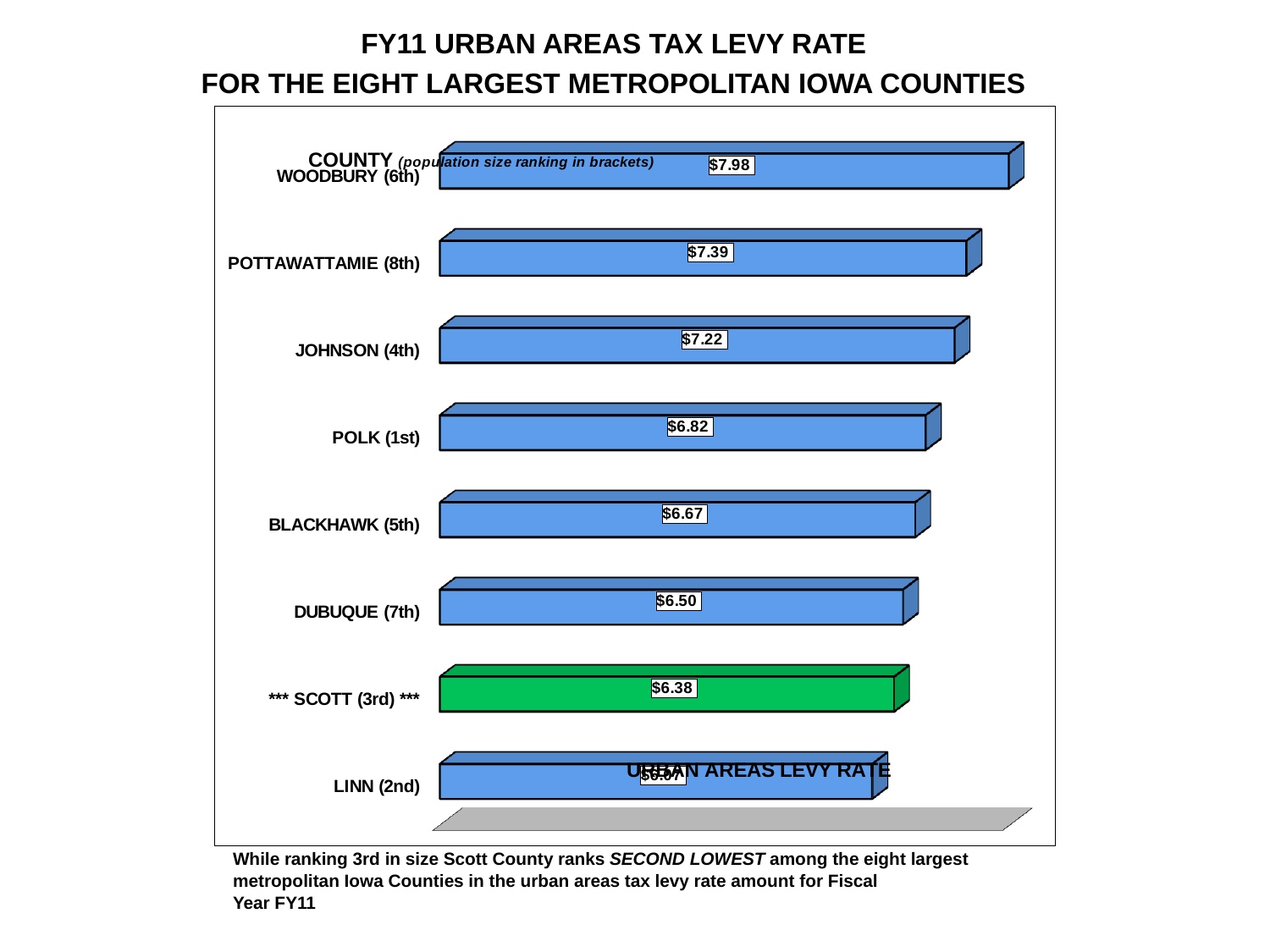
What kind of chart is shown on the slide? Bar chart What is the urban areas tax levy rate for Polk (1st)? $6.82 What is the urban areas tax levy rate for Woodbury (6th)? $7.98 What is the difference between the levy rates of Johnson (4th) and Dubuque (7th)? $0.72 Which county has the highest urban areas tax levy rate? Woodbury (6th) Which county's bar is coloured green instead of blue? Scott (3rd) What is the urban areas tax levy rate for Pottawattamie (8th)? $7.39 How many counties are shown in the chart? 8 Which county has the lowest urban areas tax levy rate? Linn (2nd) Which has a higher levy rate, Blackhawk (5th) or Dubuque (7th)? Blackhawk (5th) What is the difference between the levy rates of Woodbury (6th) and Scott (3rd)? $1.60 What is the urban areas tax levy rate for Scott (3rd)? $6.38